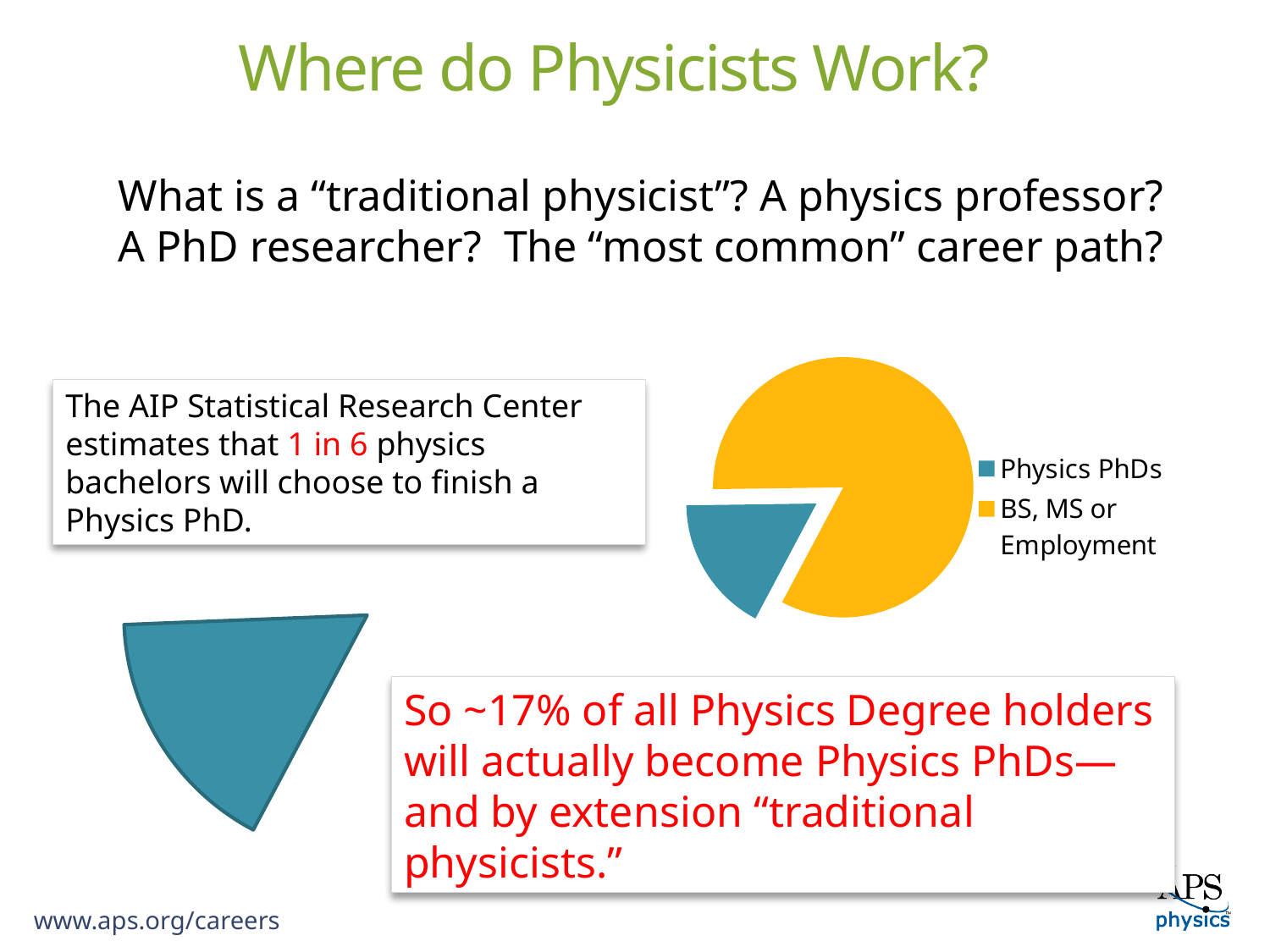
Which slice of the pie chart is pulled out (exploded) from the rest of the pie? Physics PhDs Which slice is larger in the pie chart, Physics PhDs or BS, MS or Employment? BS, MS or Employment How many slices does the pie chart have? 2 Which slice of the pie chart is the largest? BS, MS or Employment Which slice of the pie chart is the smallest? Physics PhDs How many entries does the pie chart's legend list? 2 What colour is the Physics PhDs slice in the pie chart? teal What kind of chart is shown on the slide? pie chart